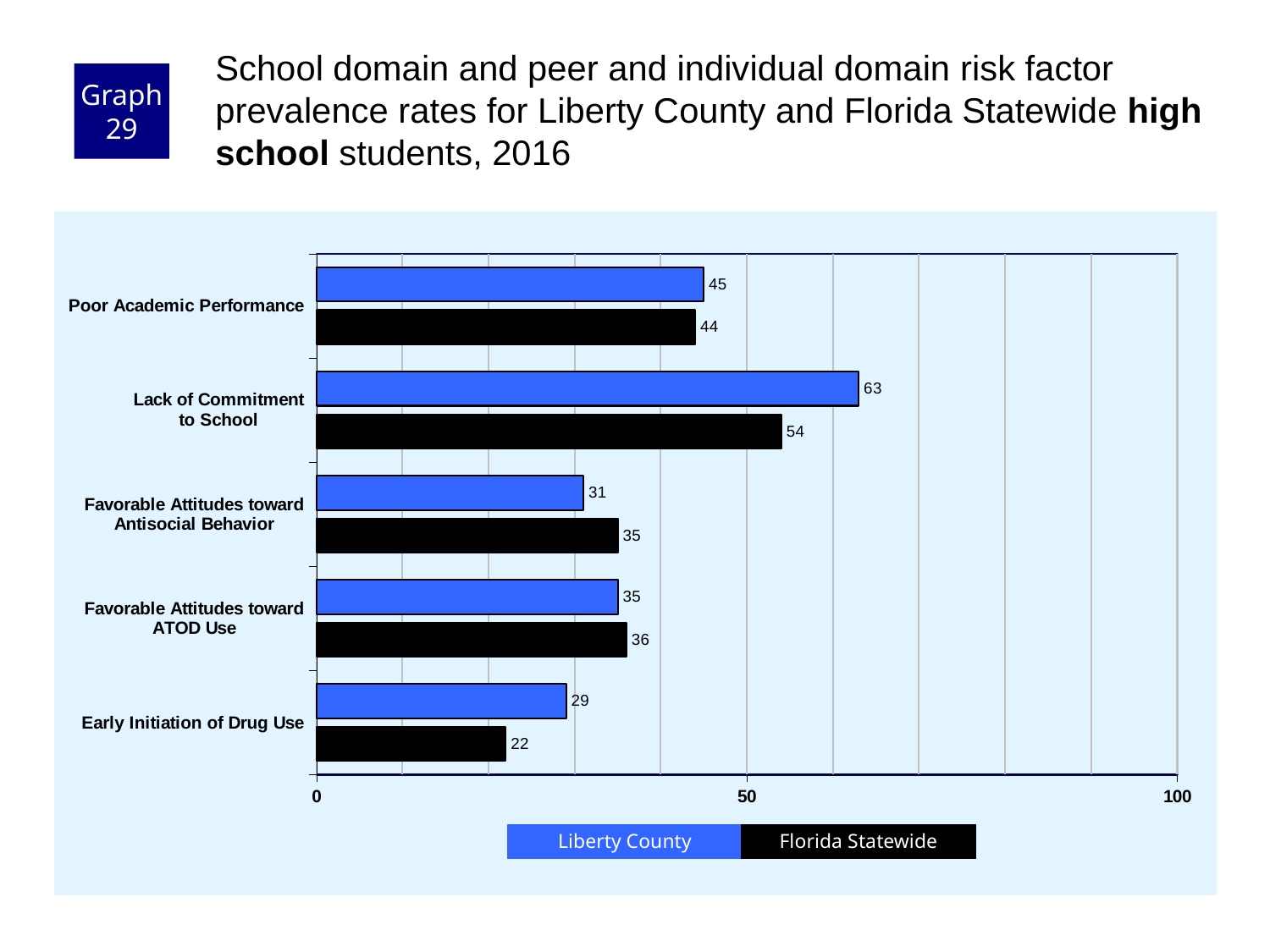
Which category has the lowest Florida Statewide value? Early Initiation of Drug Use What is the difference between the Liberty County and Florida Statewide values for Lack of Commitment to School? 9 How many risk factor categories are shown on the chart? 5 Which category has the highest Liberty County value? Lack of Commitment to School Is the Liberty County value for Lack of Commitment to School greater or less than 50? greater What kind of chart is shown on the slide? bar chart What is the Florida Statewide value for Favorable Attitudes toward Antisocial Behavior? 35 What is the Liberty County value for Lack of Commitment to School? 63 What is the difference between the Liberty County and Florida Statewide values for Early Initiation of Drug Use? 7 How many series does the legend list? 2 Which is larger for Favorable Attitudes toward Antisocial Behavior: the Liberty County value or the Florida Statewide value? Florida Statewide What is the Florida Statewide value for Early Initiation of Drug Use? 22